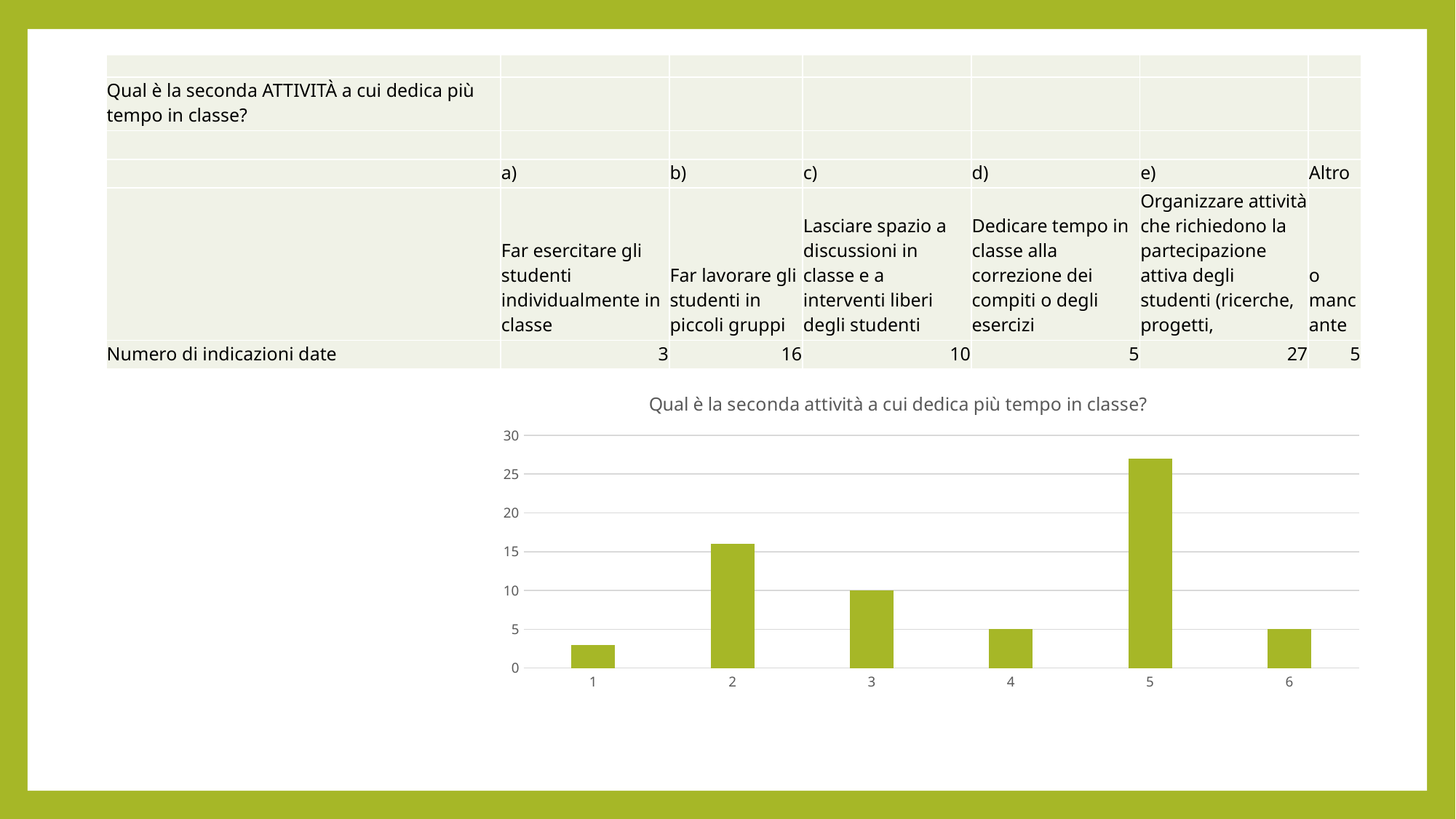
Which category has the lowest bar in the chart? 1 How many bars does the chart have? 6 What is the title of the chart? Qual è la seconda attività a cui dedica più tempo in classe? Is the value for category 2 greater or less than 15? greater What is the value for category 3 in the chart? 10 What is the value for category 5 in the chart? 27 What is the difference between the value for category 5 and the value for category 2? 11 What kind of chart is shown on the slide? bar chart Which category has the highest bar in the chart? 5 What is the value for category 4 in the chart? 5 Which is larger, the value for category 2 or the value for category 3? category 2 Is the value for category 1 greater or less than 5? less